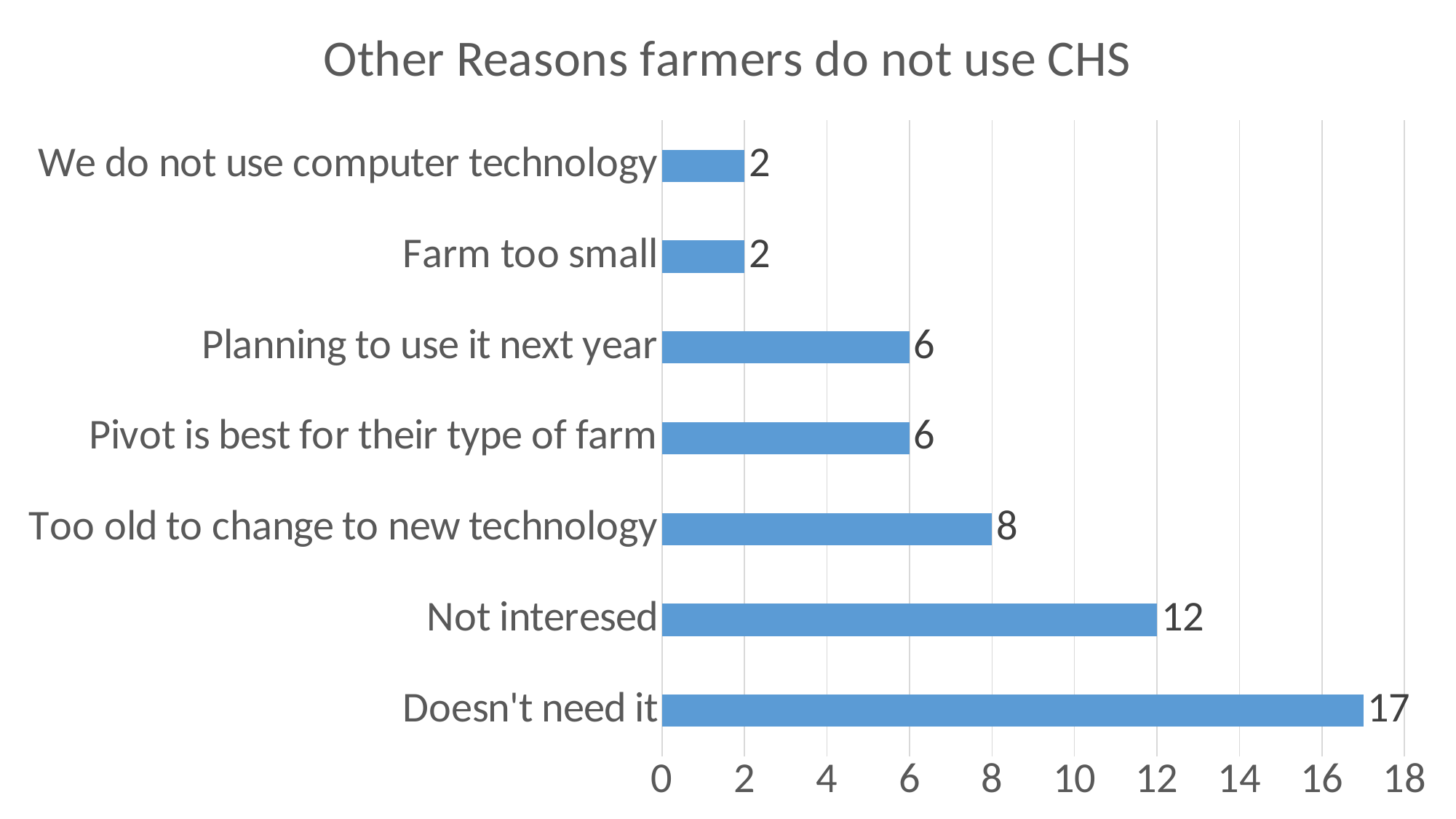
What kind of chart is shown on the slide? Bar chart What is the value for "Too old to change to new technology"? 8 What is the value for "Farm too small"? 2 How many reasons (categories) are shown in the chart? 7 What is the difference between the values for "Doesn't need it" and "Not interesed"? 5 What is the value for "Not interesed"? 12 Is the value for "Doesn't need it" greater or less than 16? greater What is the value for "Doesn't need it"? 17 Which reason has the highest value? Doesn't need it What is the title of the chart? Other Reasons farmers do not use CHS Which is larger, the value for "Not interesed" or the value for "Too old to change to new technology"? Not interesed What is the difference between the values for "Too old to change to new technology" and "Planning to use it next year"? 2